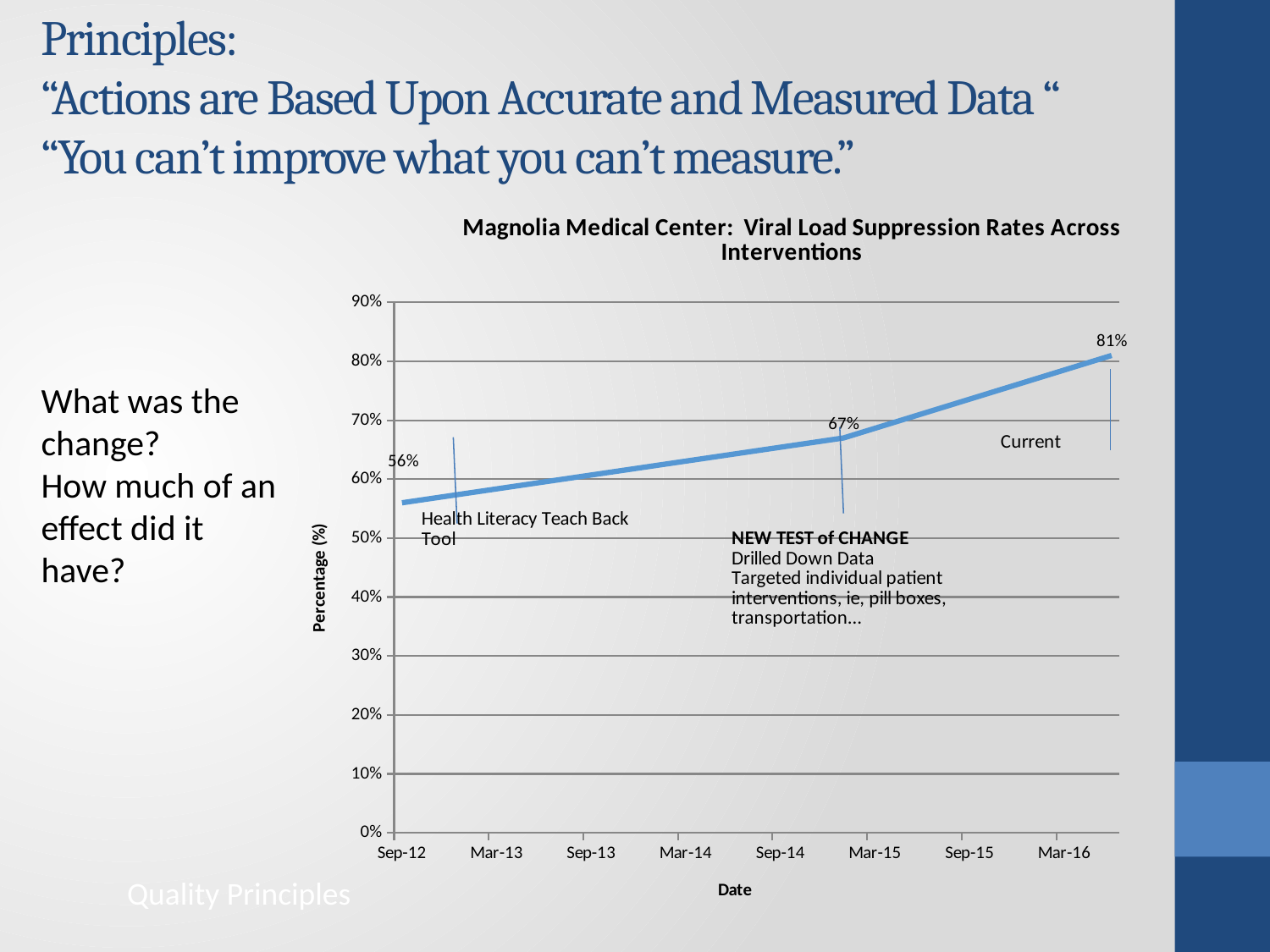
What is the value of the middle data point on the line, near the 'NEW TEST of CHANGE' annotation? 67% What is the lowest value plotted on the line? 56% What type of chart is shown on the slide? line chart Which is larger, the middle data point or the first data point? the middle data point (67%) What is the title of the chart? Magnolia Medical Center: Viral Load Suppression Rates Across Interventions How many labelled data points are plotted on the line? 3 Do the values rise or fall from Sep-12 to Mar-16? rise What is the difference between the last data point (81%) and the first data point (56%)? 25 percentage points What is the value of the first data point on the line, at Sep-12? 56% What is the value of the last data point on the line, labelled 'Current'? 81% What is the label of the vertical axis of the chart? Percentage (%) What is the highest value plotted on the line? 81%